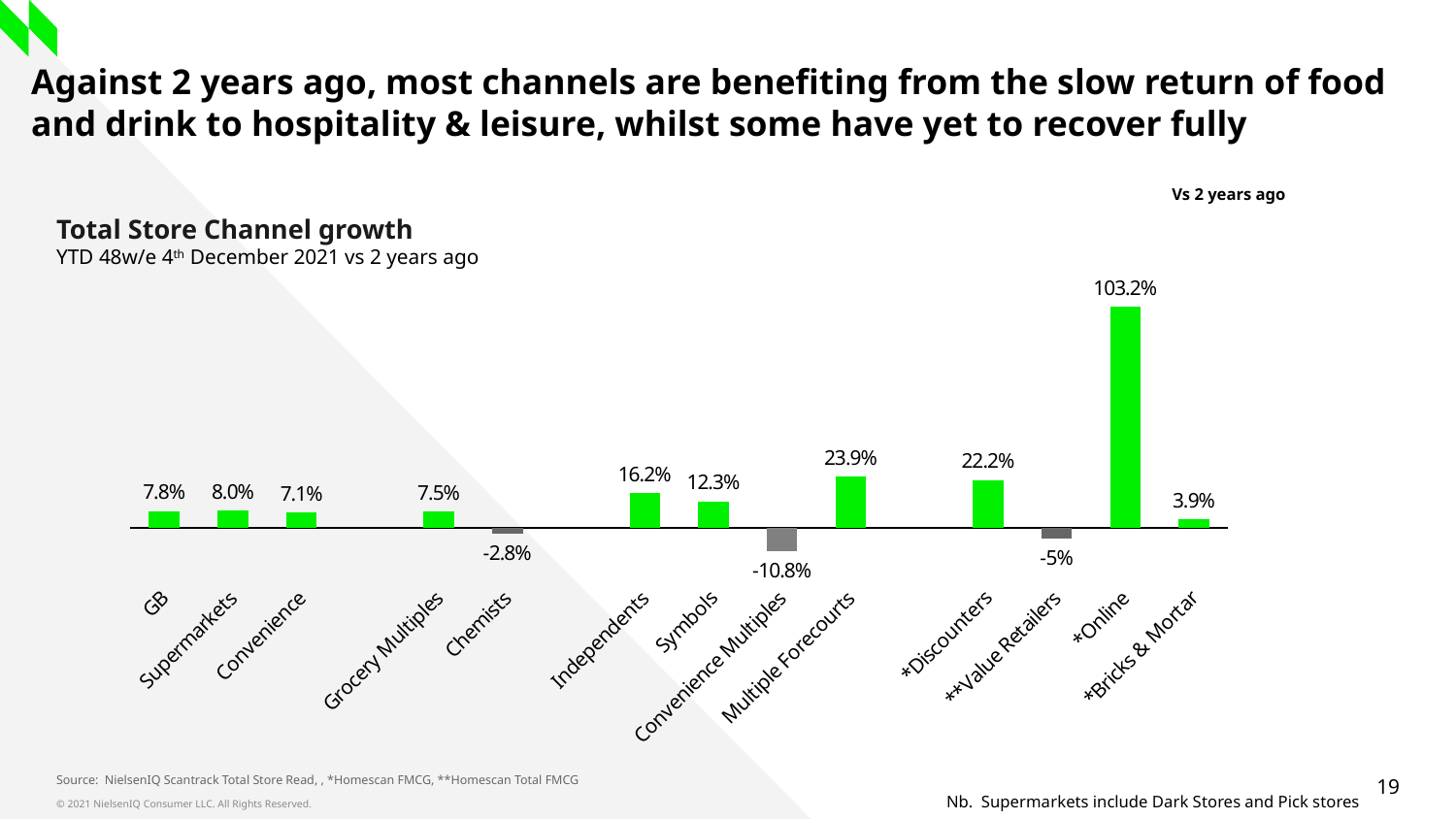
Which channel has the lowest growth value? Convenience Multiples What is the title of the chart? Total Store Channel growth Which channel has the highest growth value? *Online How many channels show a negative growth value? 3 What is the growth value for Chemists? -2.8% What is the growth value for Multiple Forecourts? 23.9% Which has a larger growth value, Independents or Symbols? Independents How many channels are plotted in the chart? 13 What kind of chart is shown on the slide? Bar chart What is the difference between the growth values for Multiple Forecourts and *Discounters? 1.7% What is the growth value for *Online? 103.2% What is the growth value for Convenience Multiples? -10.8%